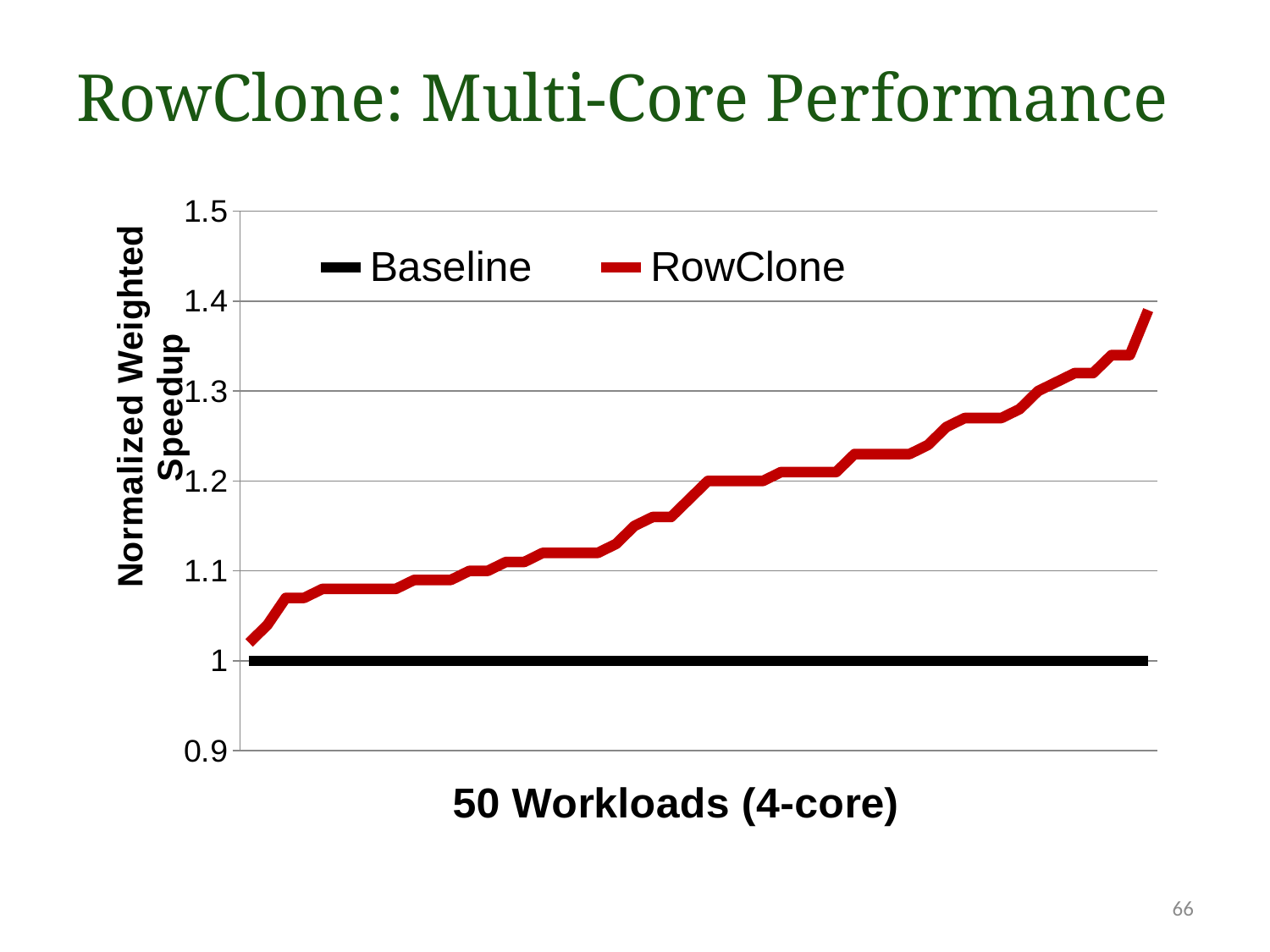
Which series has the higher Normalized Weighted Speedup, Baseline or RowClone? RowClone What kind of chart is shown on the slide? line chart Does the RowClone line rise or fall from left to right across the workloads? rise How many series does the legend list? 2 How many workloads are plotted along the x axis according to its label? 50 What are the two series named in the legend? Baseline and RowClone Is the RowClone value for the rightmost workload greater or less than 1.2? greater What is the Normalized Weighted Speedup of the Baseline series? 1 What is the label of the y axis? Normalized Weighted Speedup Is the highest RowClone value greater or less than 1.3? greater Is the lowest RowClone value greater or less than 1.1? less